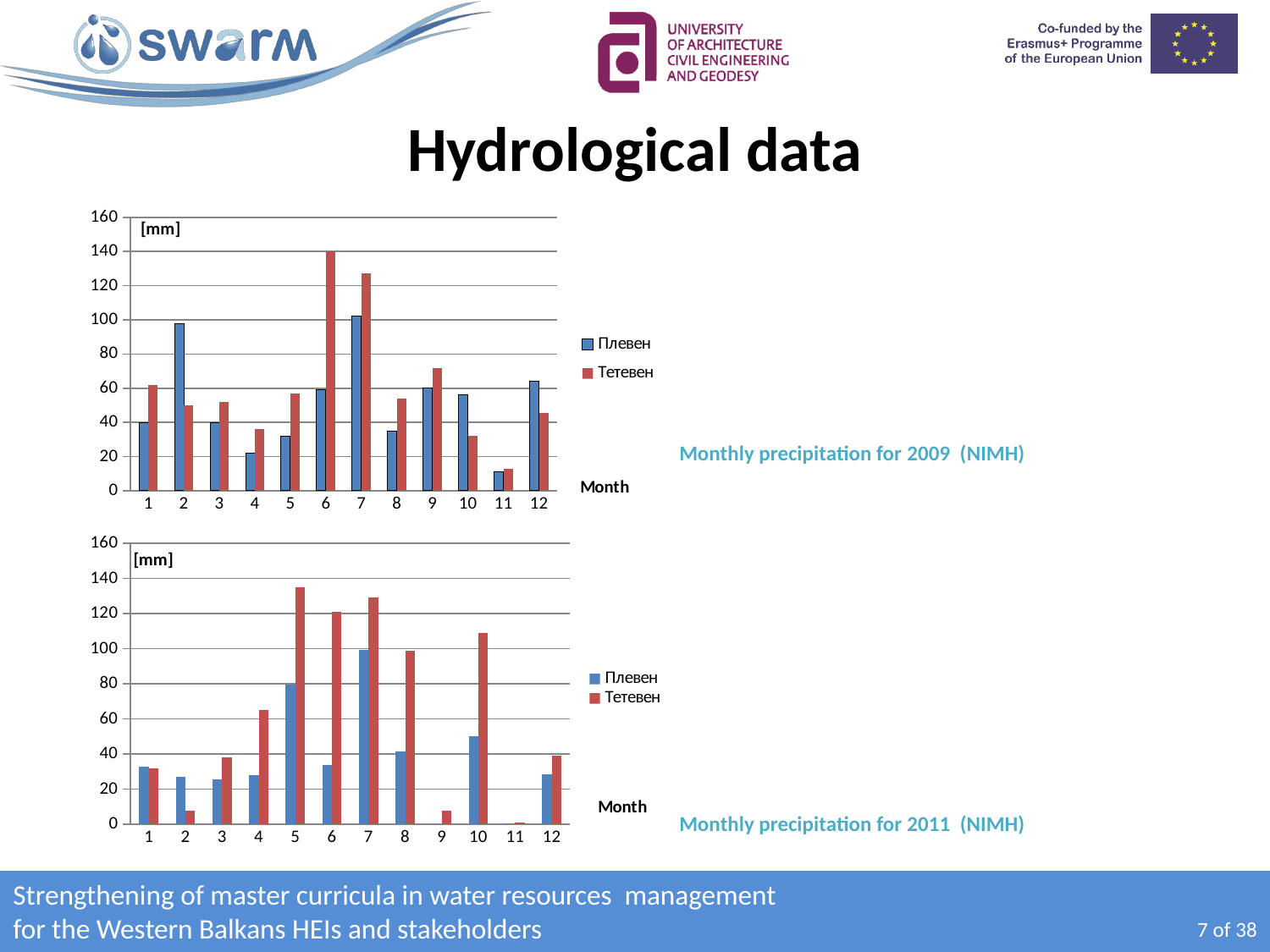
In the Monthly precipitation for 2009 chart, which month has the highest value for Плевен? 7 In the Monthly precipitation for 2009 chart, which series has the larger value in month 2, Плевен or Тетевен? Плевен In the Monthly precipitation for 2009 chart, which month has the lowest value for Плевен? 11 In the Monthly precipitation for 2011 chart, is the value for Тетевен in month 9 greater or less than 20? less How many series does the legend of the Monthly precipitation for 2011 chart list? 2 In the Monthly precipitation for 2009 chart, is the value for Плевен in month 4 greater or less than 40? less In the Monthly precipitation for 2011 chart, which month has the highest value for Тетевен? 5 In the Monthly precipitation for 2011 chart, is the value for Тетевен in month 10 greater or less than 100? greater What type of chart is the Monthly precipitation for 2009 chart? Bar chart In the Monthly precipitation for 2011 chart, which series has the larger value in month 4, Плевен or Тетевен? Тетевен In the Monthly precipitation for 2009 chart, which month has the highest value for Тетевен? 6